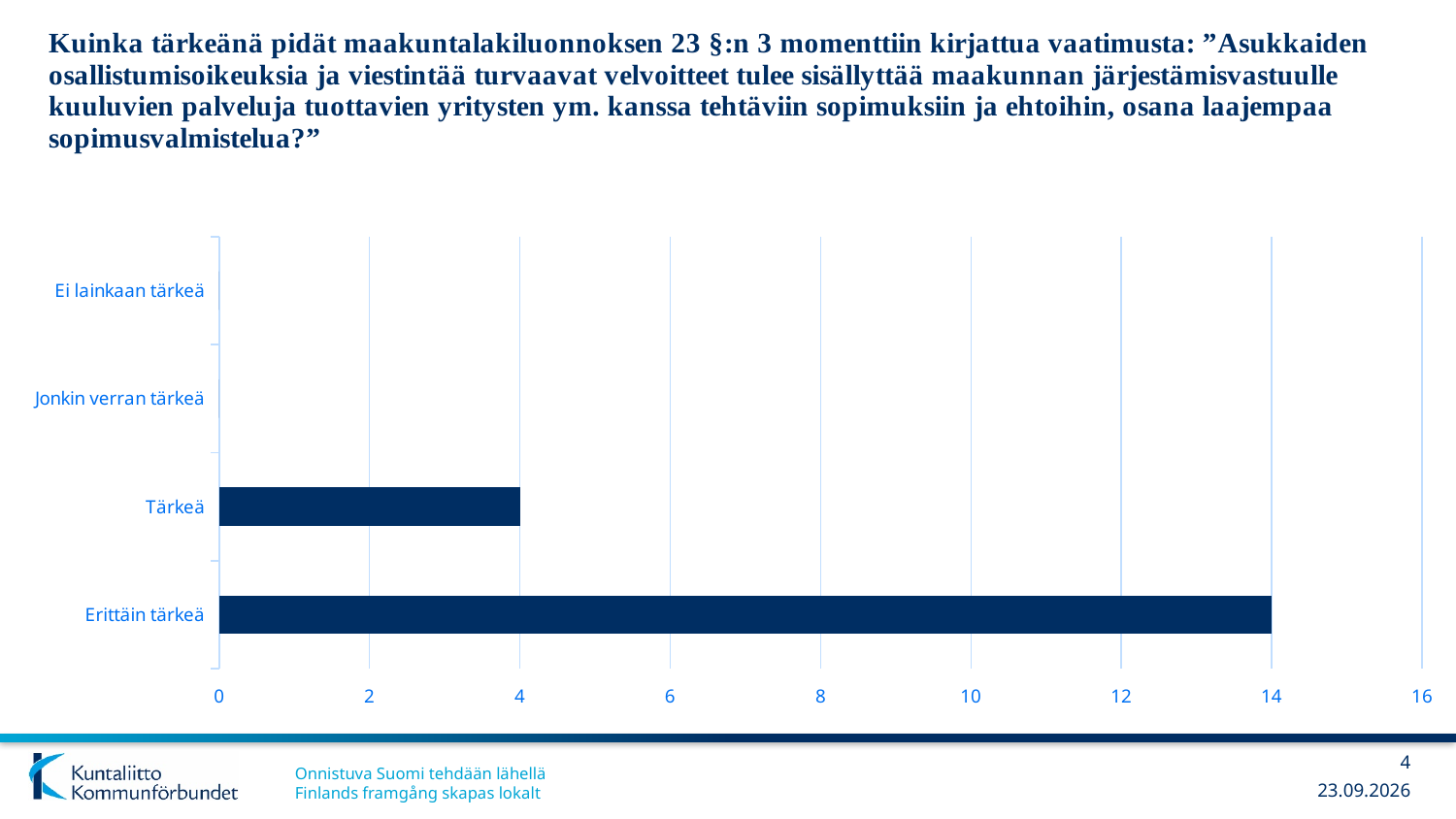
Which is larger, the value for "Erittäin tärkeä" or the value for "Tärkeä"? Erittäin tärkeä Is the value for "Erittäin tärkeä" greater or less than 10? greater Is the value for "Jonkin verran tärkeä" greater or less than 2? less Is the value for "Tärkeä" greater or less than 6? less What is the difference between the values for "Erittäin tärkeä" and "Tärkeä"? 10 Which category has the highest value? Erittäin tärkeä What kind of chart is shown on the slide? bar chart What is the highest value shown on the horizontal axis of the chart? 16 Which category is listed at the top of the vertical axis? Ei lainkaan tärkeä What is the value for "Tärkeä"? 4 How many categories are shown on the vertical axis of the chart? 4 What is the value for "Erittäin tärkeä"? 14